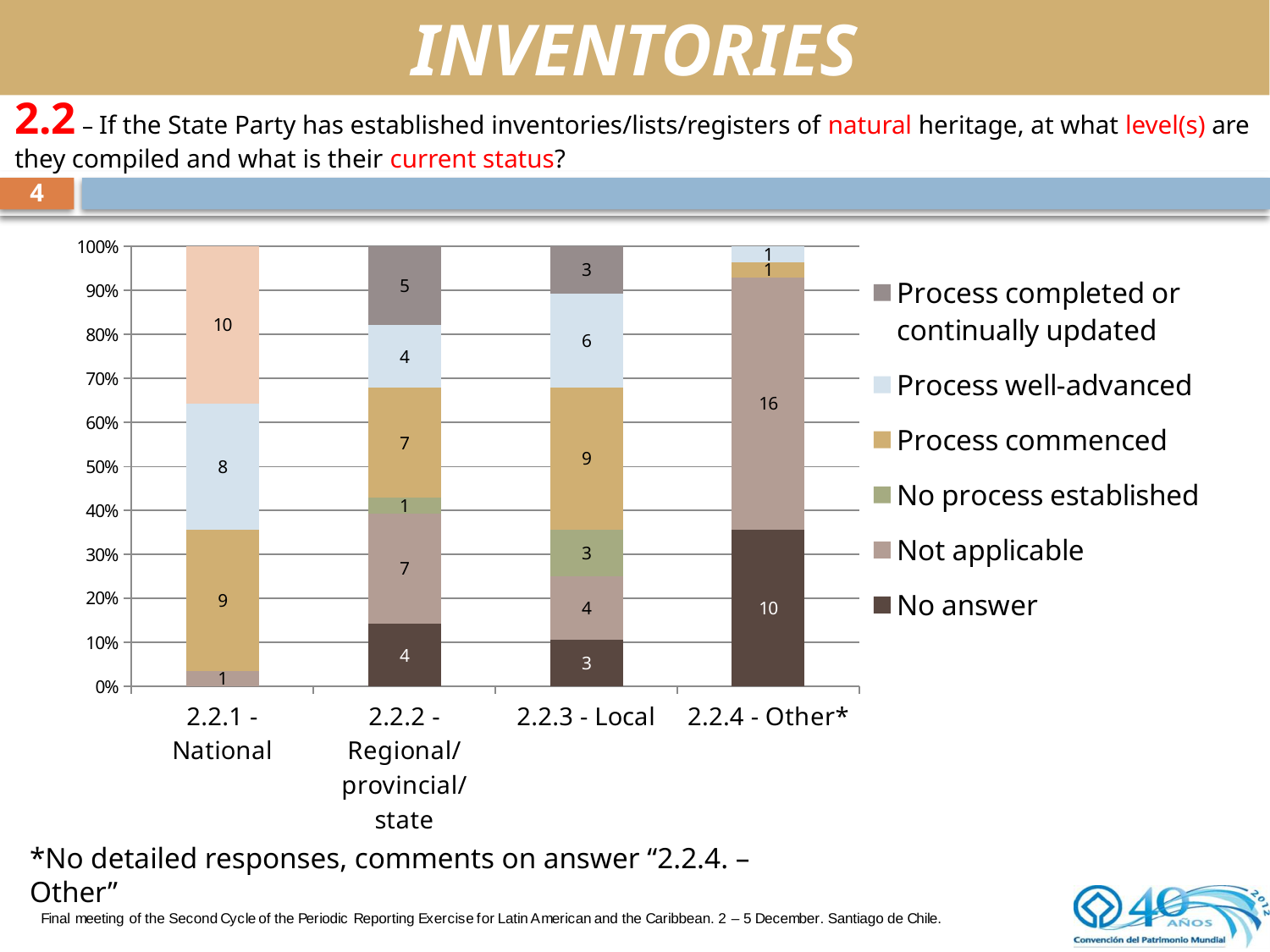
How many series does the chart's legend list? 6 What is the value for 'Not applicable' in the 2.2.4 - Other* bar? 16 What is the value for 'Process commenced' in the 2.2.3 - Local bar? 9 How many categories are shown along the x axis of the chart? 4 Which category has the highest 'Not applicable' value? 2.2.4 - Other* What kind of chart is shown on the slide? Stacked bar chart Which has the larger 'No answer' value, 2.2.2 - Regional/provincial/state or 2.2.3 - Local? 2.2.2 - Regional/provincial/state What is the value for 'Process well-advanced' in the 2.2.1 - National bar? 8 What is the value for 'Process completed or continually updated' in the 2.2.2 - Regional/provincial/state bar? 5 What is the difference between the 'Not applicable' values for 2.2.4 - Other* and 2.2.2 - Regional/provincial/state? 9 What is the total of all segments in the 2.2.3 - Local bar? 28 What is the value for 'No answer' in the 2.2.4 - Other* bar? 10